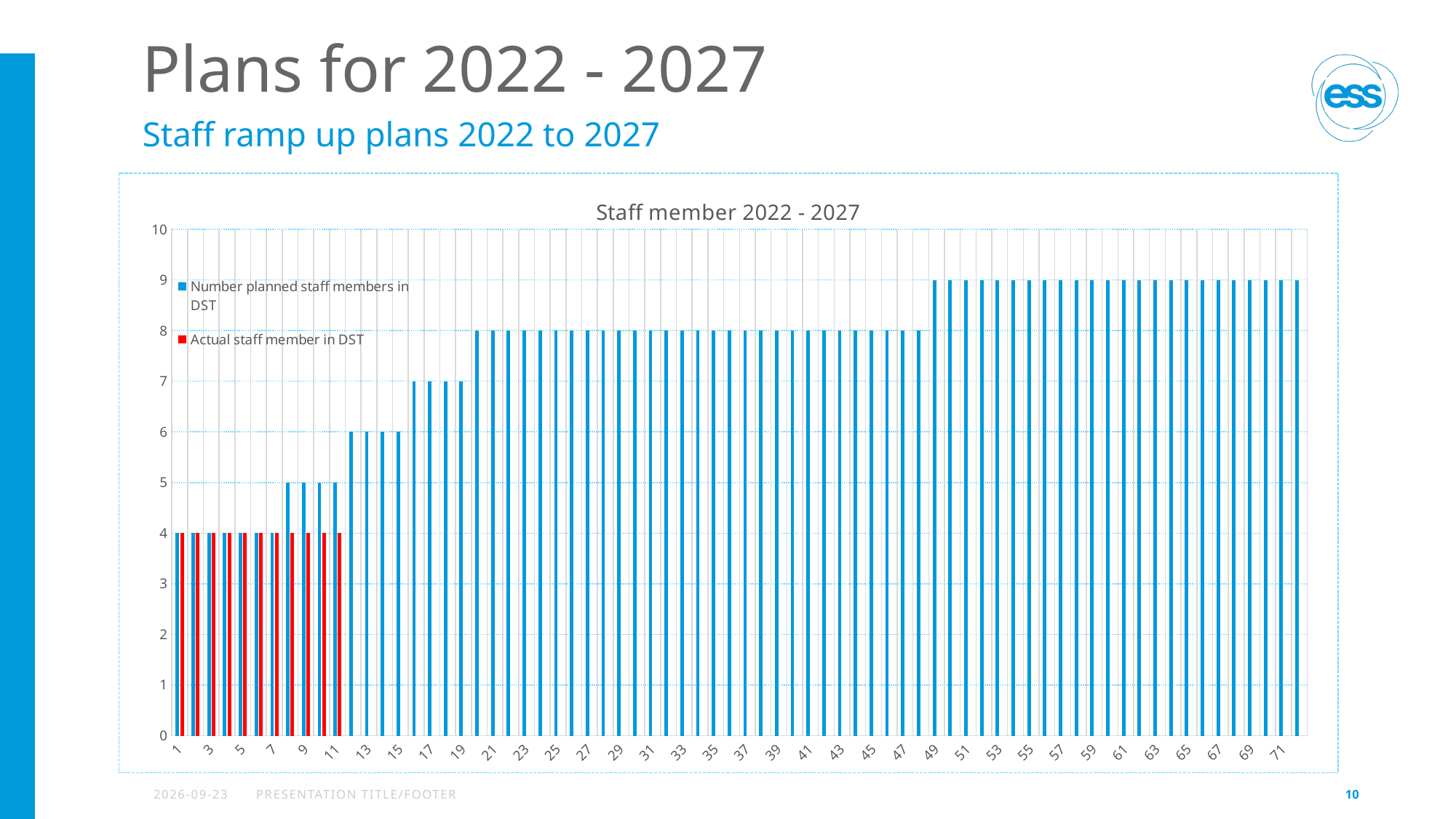
What type of chart is shown on the slide? bar chart How many series does the chart legend list? 2 Do the planned staff member values rise or fall along the x axis? rise What is the highest value reached by the planned staff members series? 9 What is the title of the chart? Staff member 2022 - 2027 What is the number of planned staff members in DST at month 71? 9 What is the number of planned staff members in DST at month 13? 6 What is the number of planned staff members in DST at month 1? 4 What is the actual staff member count in DST at month 5? 4 What is the number of planned staff members in DST at month 9? 5 Which series is shown in red? Actual staff member in DST What is the number of planned staff members in DST at month 17? 7